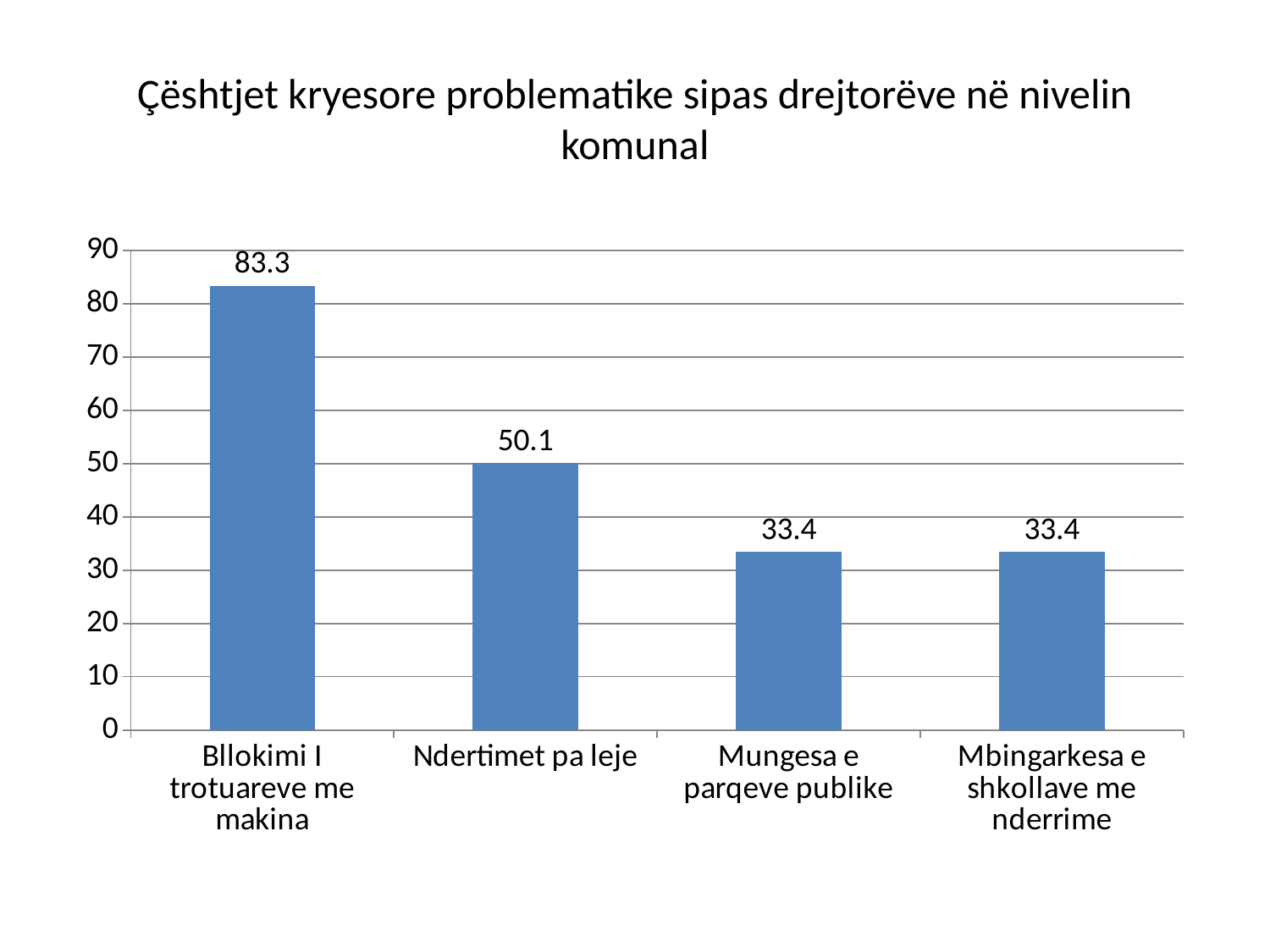
What is the difference between the values for Bllokimi I trotuareve me makina and Ndertimet pa leje? 33.2 Which category has the highest value? Bllokimi I trotuareve me makina Which is larger, the value for Ndertimet pa leje or the value for Mbingarkesa e shkollave me nderrime? Ndertimet pa leje What is the value for Bllokimi I trotuareve me makina? 83.3 What is the difference between the values for Ndertimet pa leje and Mungesa e parqeve publike? 16.7 What is the title of the chart? Çështjet kryesore problematike sipas drejtorëve në nivelin komunal What is the value for Ndertimet pa leje? 50.1 Is the value for Ndertimet pa leje greater or less than 40? greater How many categories are shown in the chart? 4 What kind of chart is shown on the slide? bar chart What is the value for Mungesa e parqeve publike? 33.4 What is the value for Mbingarkesa e shkollave me nderrime? 33.4